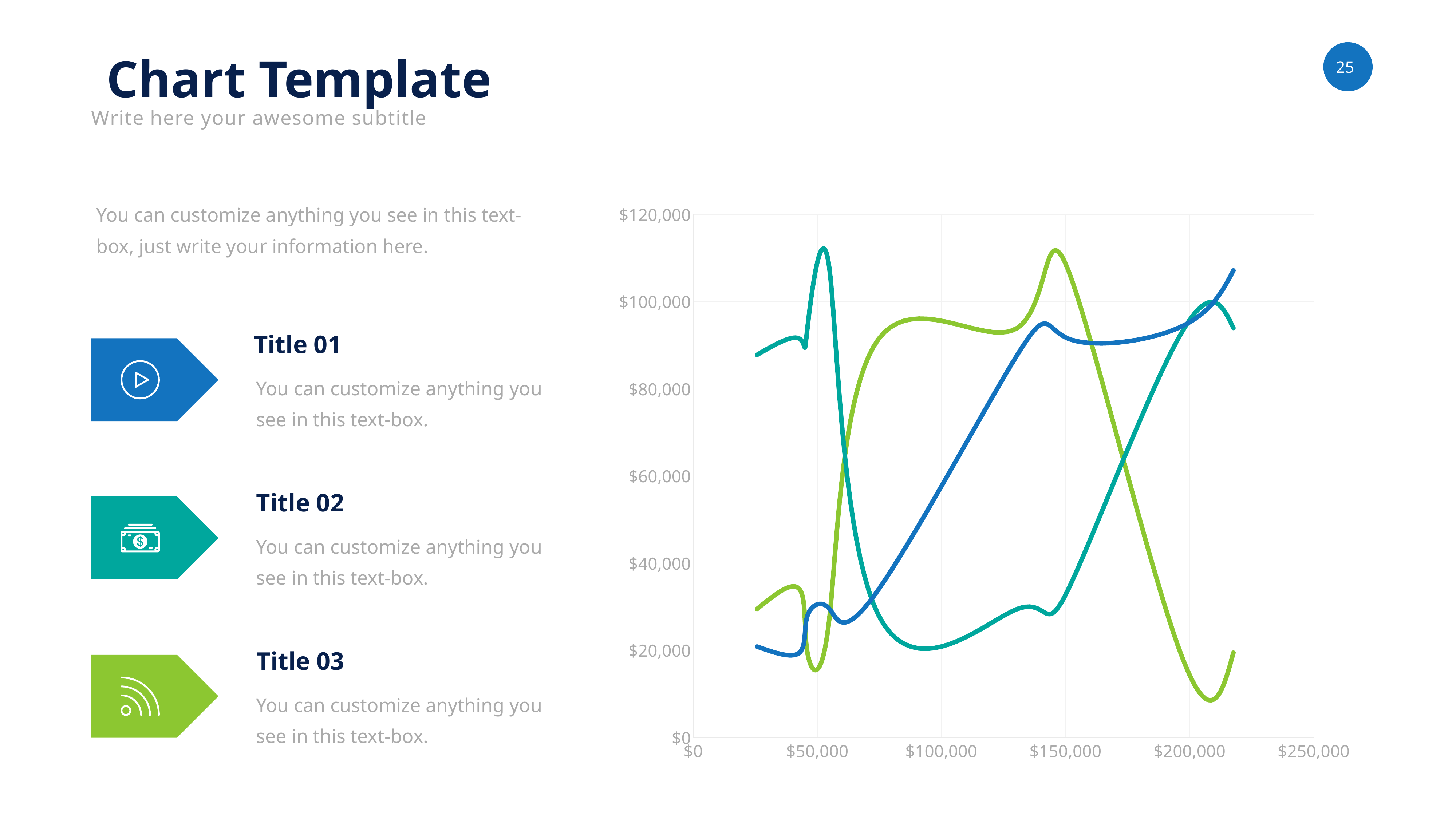
What is the highest value shown on the chart's vertical axis? $120,000 Does the blue line overall rise or fall from the left of the chart to the right? rise Is the value of the teal line at $200,000 on the horizontal axis greater or less than $80,000? greater At $150,000 on the horizontal axis, which line has the larger value, the green line or the teal line? green line Is the value of the green line at $150,000 on the horizontal axis greater or less than $100,000? greater What kind of chart is shown on the slide? line chart What is the highest value shown on the chart's horizontal axis? $250,000 How many lines are plotted on the chart? 3 Is the value of the teal line at $100,000 on the horizontal axis greater or less than $40,000? less At $50,000 on the horizontal axis, which line has the larger value, the teal line or the blue line? teal line